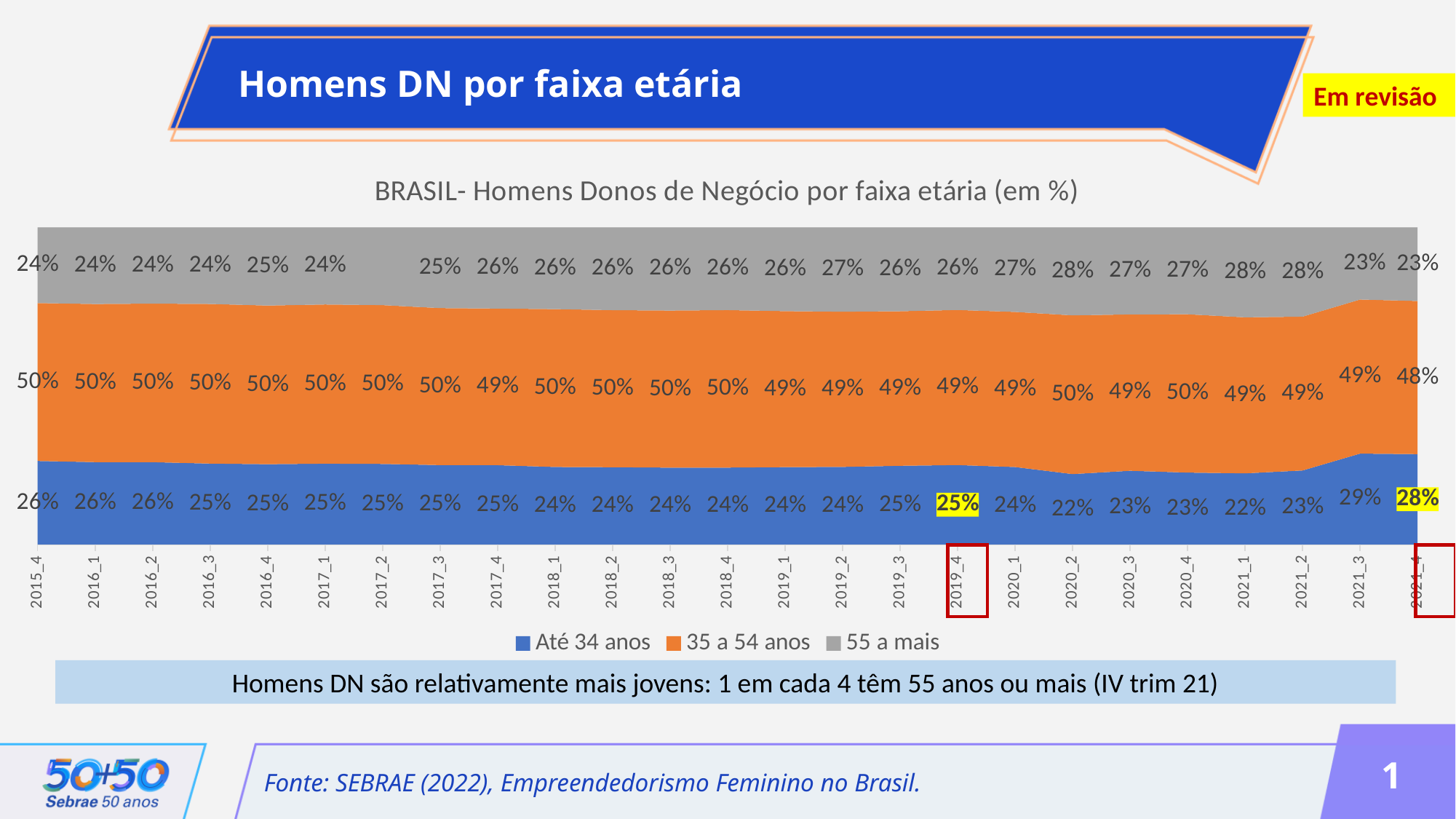
In which period is the '35 a 54 anos' share lowest? 2021_4 What kind of chart is shown? Stacked area chart How many periods are shown on the x axis? 25 How many series does the legend list? 3 In which period is the 'Até 34 anos' share highest? 2021_3 What is the value for '35 a 54 anos' in 2021_4? 48% Which is larger: the 'Até 34 anos' value in 2019_4 or in 2021_4? 2021_4 What is the value for 'Até 34 anos' in 2020_2? 22% What is the value for 'Até 34 anos' in 2021_4? 28% What is the difference between the 'Até 34 anos' and '55 a mais' values in 2021_4? 5 percentage points What is the value for '55 a mais' in 2019_4? 26% Does the '55 a mais' share rise or fall from 2015_4 to 2021_2? Rises